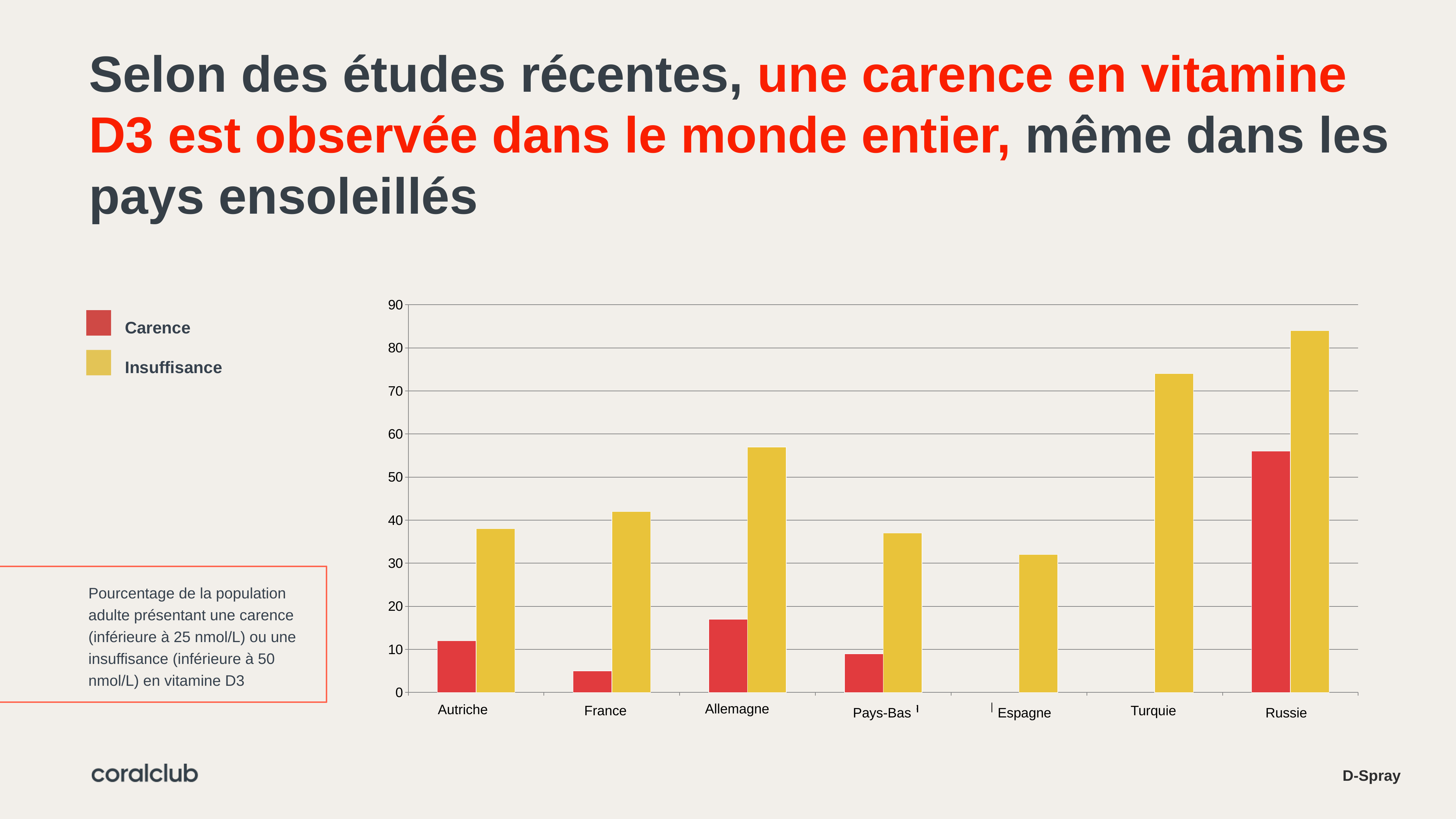
How many series does the legend list? 2 Is the Insuffisance value for Russie greater or less than 80? greater What kind of chart is shown on the slide? bar chart How many countries are shown on the x axis of the chart? 7 Which is larger, the Insuffisance value for Allemagne or for France? Allemagne Which colour represents the Carence series in the chart? red Is the Carence value for France greater or less than 10? less Is the Carence value for Russie greater or less than 50? greater Which country has the highest Carence value? Russie Which country has the highest Insuffisance value? Russie Which country has the lowest Insuffisance value? Espagne